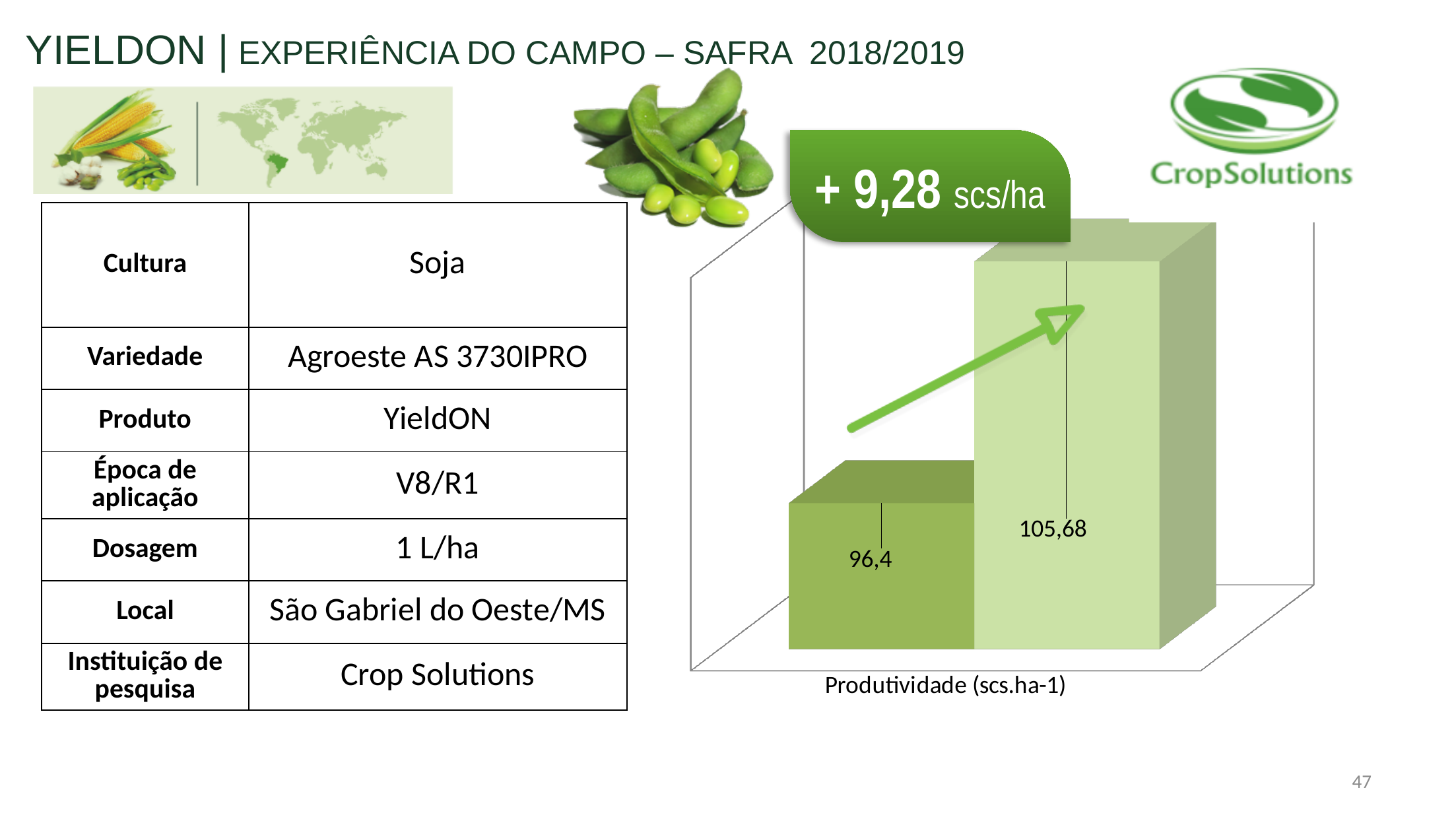
Which is larger in the chart, the left bar or the right bar? the right bar Do the bar values rise or fall from left to right in the chart? rise Which bar in the chart has the lowest value? the left (darker green) bar, 96,4 What gain is stated in the green callout above the chart? + 9,28 scs/ha What value is labelled on the right (lighter green) bar of the chart? 105,68 What is the difference between the right bar (105,68) and the left bar (96,4) in the chart? 9,28 What kind of chart is shown on the right side of the slide? bar chart Which bar in the chart has the highest value? the right (lighter green) bar, 105,68 What is the axis label shown beneath the bars of the chart? Produtividade (scs.ha-1) How many bars are plotted in the chart? 2 What value is labelled on the left (darker green) bar of the chart? 96,4